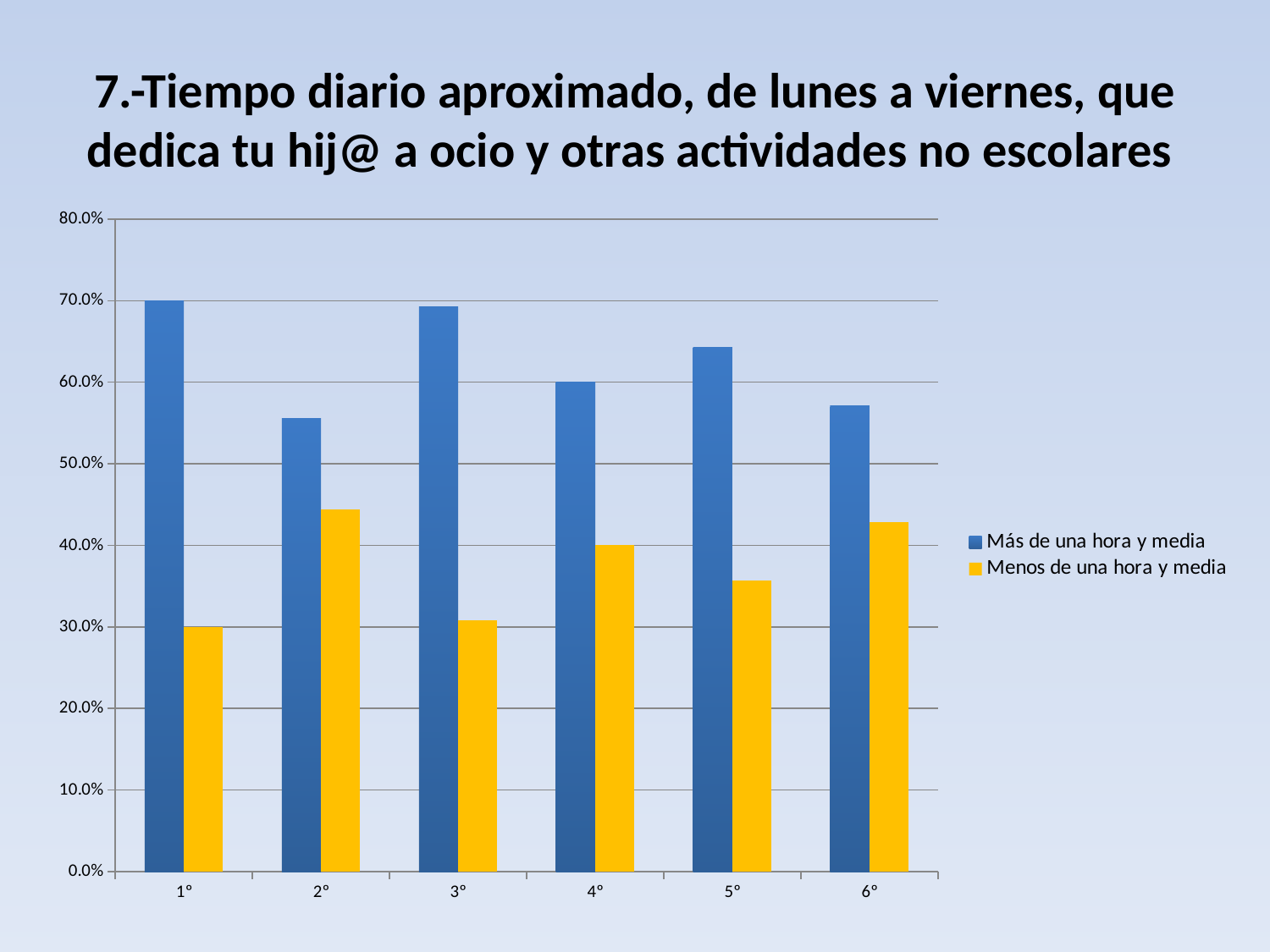
What kind of chart is shown on the slide? bar chart Which series is shown in yellow? Menos de una hora y media How many categories are shown on the x axis? 6 Is the value for 'Menos de una hora y media' in 3° greater or less than 40.0%? less Which is larger for 'Menos de una hora y media': 2° or 3°? 2° What is the value for 'Más de una hora y media' in 1°? 70.0% Which is larger for 'Más de una hora y media': 1° or 2°? 1° Is the value for 'Menos de una hora y media' in 6° greater or less than 50.0%? less Is the value for 'Más de una hora y media' in 2° greater or less than 50.0%? greater How many series does the legend list? 2